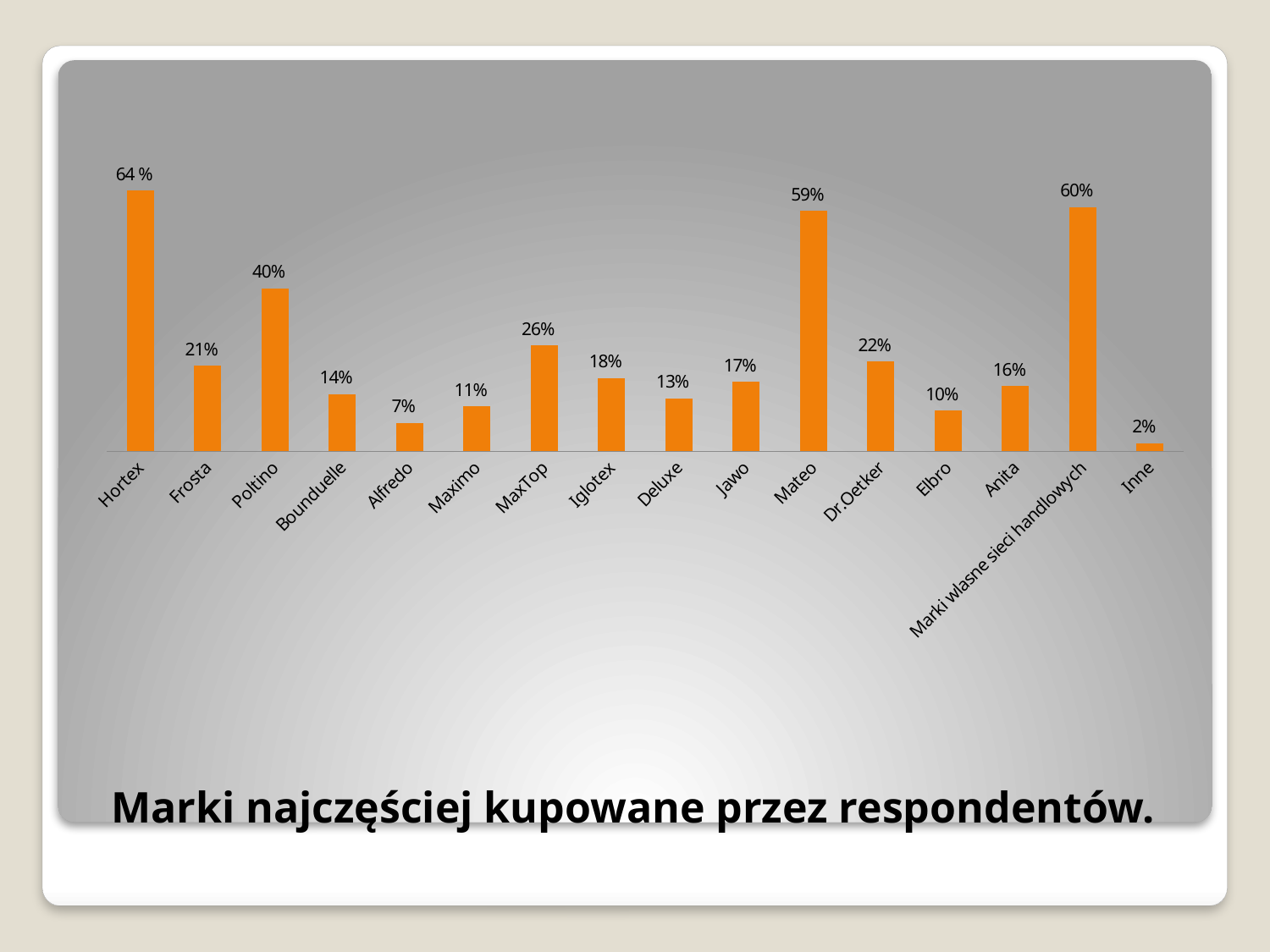
Which is larger, the value for MaxTop or the value for Dr.Oetker? MaxTop How many categories are shown on the x axis? 16 What is the value for Alfredo? 7% Which category has the highest value? Hortex What kind of chart is shown on the slide? Bar chart What is the value for Marki własne sieci handlowych? 60% What is the value for Hortex? 64 % What is the difference between the values for Poltino and Frosta? 19% Which is larger, the value for Mateo or the value for Marki własne sieci handlowych? Marki własne sieci handlowych Which category has the lowest value? Inne What is the title of the chart? Marki najczęściej kupowane przez respondentów. What is the value for Mateo? 59%